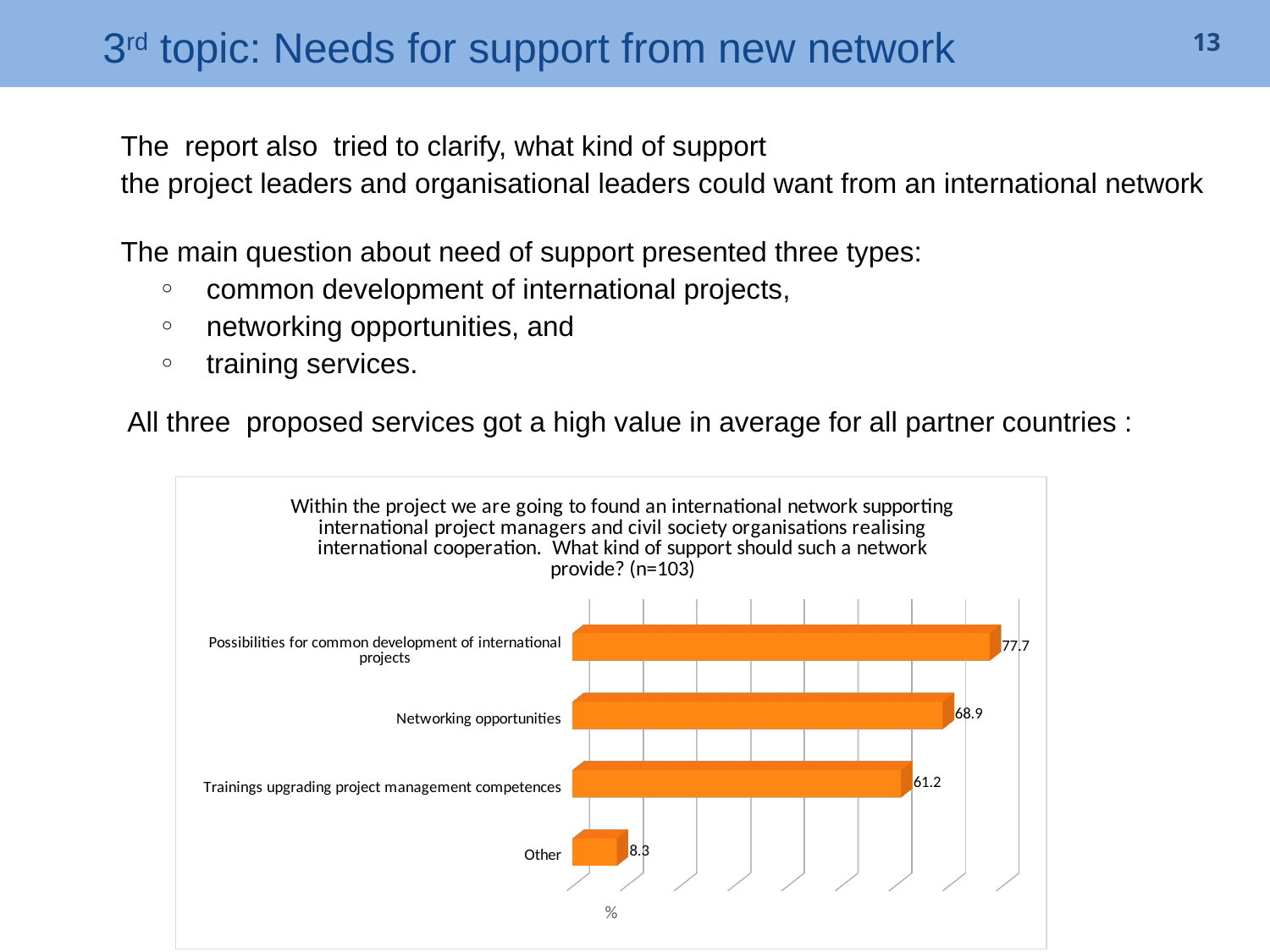
What value is shown for "Trainings upgrading project management competences"? 61.2 Which category has the highest value? Possibilities for common development of international projects What is the sample size (n) stated in the chart title? 103 Which category has the lowest value? Other Which has a larger value, "Networking opportunities" or "Trainings upgrading project management competences"? Networking opportunities How many categories are shown in the chart? 4 What is the difference between the values for "Possibilities for common development of international projects" and "Networking opportunities"? 8.8 What value is shown for "Networking opportunities"? 68.9 What kind of chart is shown on the slide? Bar chart What value is shown for "Other"? 8.3 What value is shown for "Possibilities for common development of international projects"? 77.7 What is the difference between the values for "Networking opportunities" and "Trainings upgrading project management competences"? 7.7